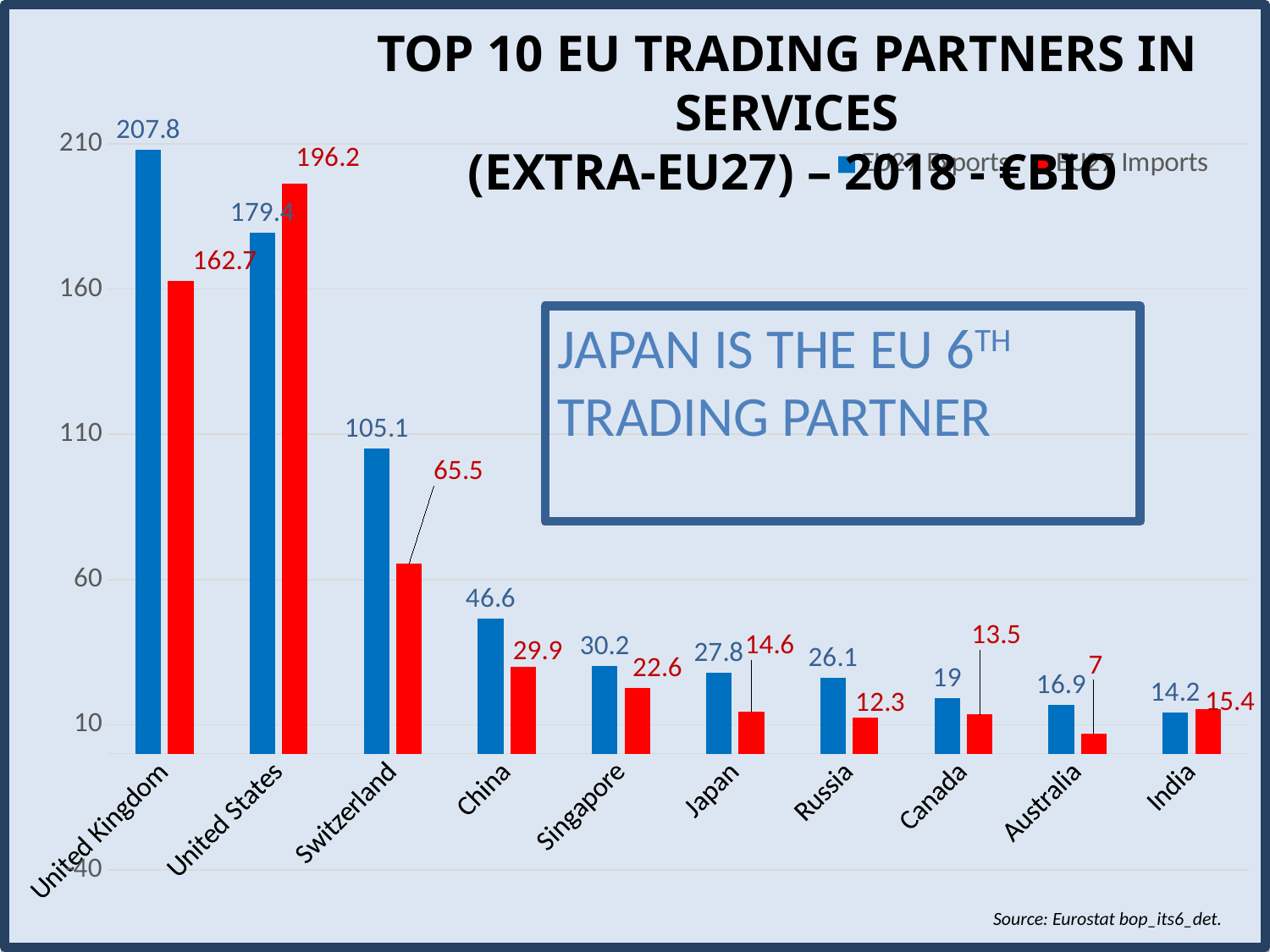
Which country has the highest blue (EU27 Exports) bar? United Kingdom Do the blue (EU27 Exports) bars rise or fall from left to right across the countries? Fall What is the difference between the blue and red bars for the United Kingdom? 45.1 For the United States, which bar is larger, the blue (EU27 Exports) or the red (EU27 Imports)? Red (EU27 Imports) What is the difference between the red and blue bars for India? 1.2 What kind of chart is shown on the slide? Bar chart How many series does the chart's legend list? 2 Which country has the lowest red (EU27 Imports) bar? Australia How many countries are shown on the x axis of the chart? 10 What is the value of the blue (EU27 Exports) bar for Switzerland? 105.1 What is the value of the red (EU27 Imports) bar for Japan? 14.6 What is the value of the blue (EU27 Exports) bar for Canada? 19